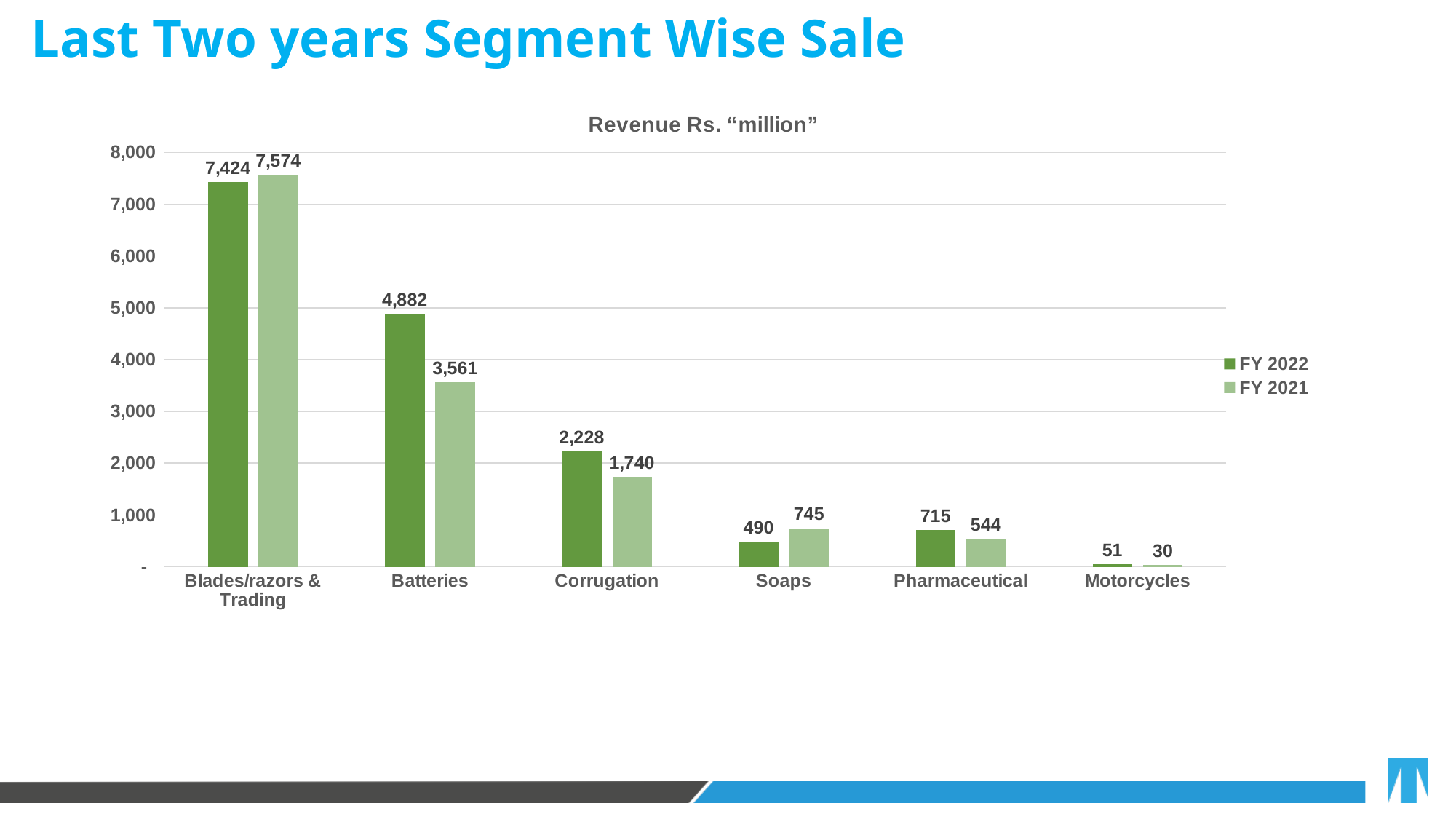
What is the FY 2022 revenue for Batteries? 4,882 Which segment has the lowest FY 2022 revenue? Motorcycles What kind of chart is shown on the slide? Bar chart Which is larger for Soaps, the FY 2022 or the FY 2021 revenue? FY 2021 How many segments are shown on the x axis? 6 What is the FY 2022 revenue for Motorcycles? 51 What is the difference between the FY 2021 and FY 2022 revenue for Blades/razors & Trading? 150 Which segment has the highest FY 2021 revenue? Blades/razors & Trading What is the FY 2021 revenue for Soaps? 745 How many series does the legend list? 2 What is the difference between the FY 2022 and FY 2021 revenue for Batteries? 1,321 Which is larger for Pharmaceutical, the FY 2022 or the FY 2021 revenue? FY 2022